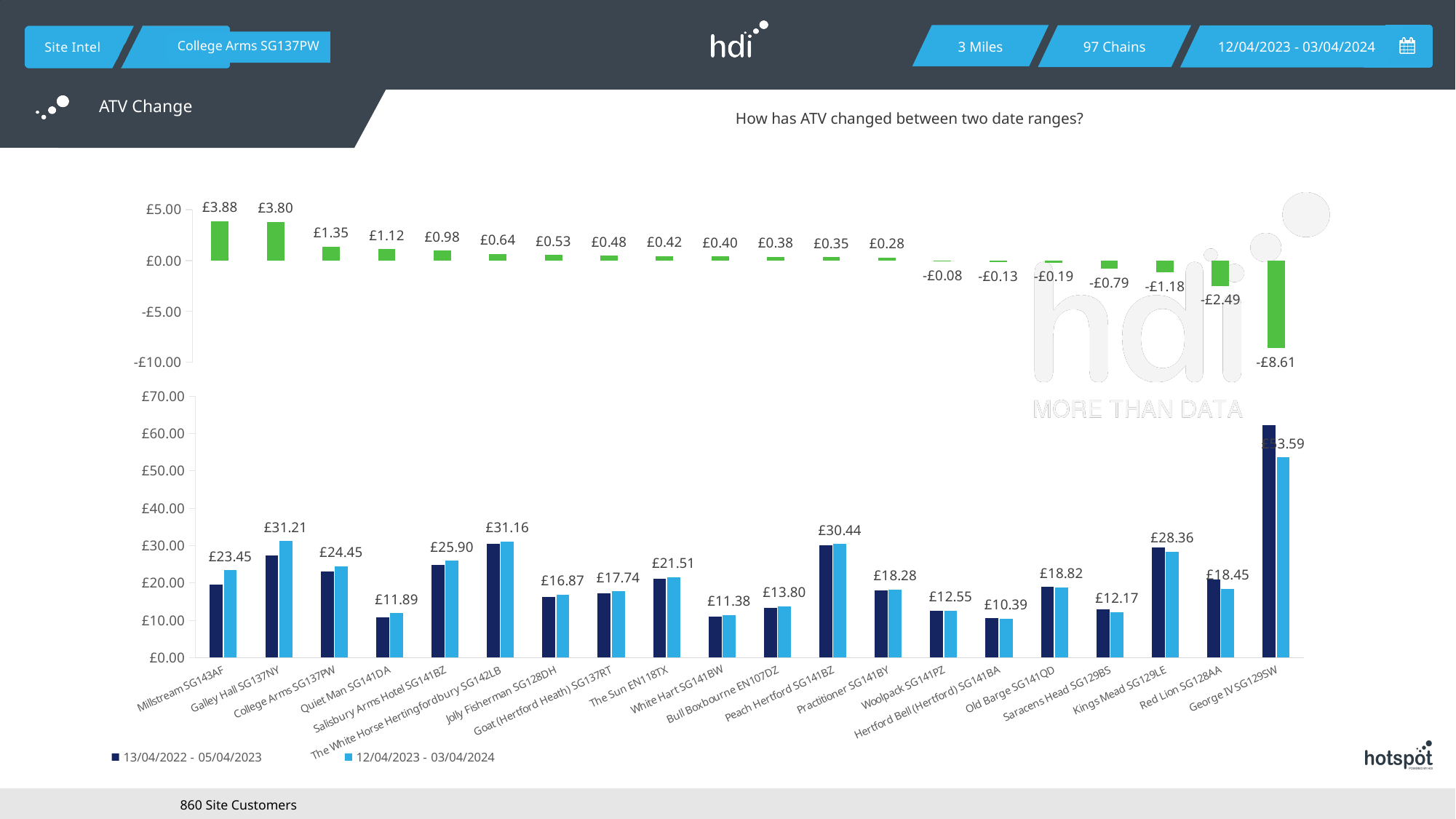
How many categories are shown on the x axis of the bottom chart? 20 In the bottom chart, what is the labelled value for George IV SG129SW in the 12/04/2023 - 03/04/2024 period? £53.59 How many series does the legend of the bottom chart list? 2 In the top chart (ATV change), which category has the highest value? Millstream SG143AF In the top chart (ATV change), what is the value for George IV SG129SW? -£8.61 In the bottom chart, what is the labelled value for Galley Hall SG137NY in the 12/04/2023 - 03/04/2024 period? £31.21 In the top chart (ATV change), do the values rise or fall moving from left to right along the x axis? fall In the bottom chart, what is the difference between the labelled 12/04/2023 - 03/04/2024 values for Galley Hall SG137NY and Millstream SG143AF? £7.76 In the bottom chart, which category has the highest labelled value for the 12/04/2023 - 03/04/2024 period? George IV SG129SW In the top chart (ATV change), what is the value for Millstream SG143AF? £3.88 In the top chart (ATV change), which category has the lowest value? George IV SG129SW In the bottom chart, is the 13/04/2022 - 05/04/2023 bar for Galley Hall SG137NY greater or less than £20.00? greater